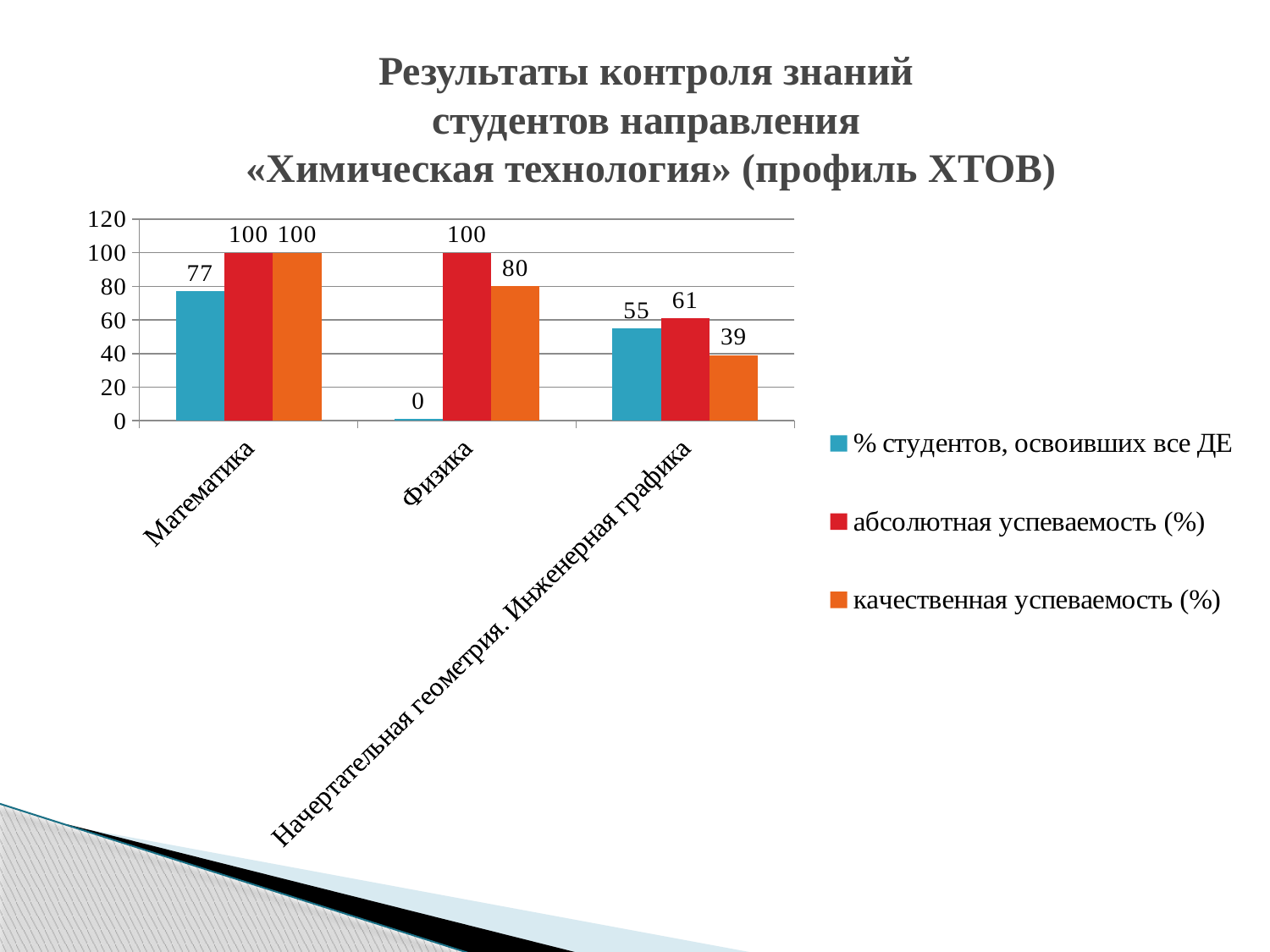
Which subject has the lowest value for «качественная успеваемость (%)»? Начертательная геометрия. Инженерная графика What is the value of «% студентов, освоивших все ДЕ» for Математика? 77 How many series does the legend list? 3 What is the difference between «абсолютная успеваемость (%)» and «качественная успеваемость (%)» for Начертательная геометрия. Инженерная графика? 22 Which subject has the highest value for «% студентов, освоивших все ДЕ»? Математика How many subject categories are shown on the x axis? 3 Does the value of «% студентов, освоивших все ДЕ» rise or fall from Математика to Начертательная геометрия. Инженерная графика? fall What kind of chart is shown on the slide? bar chart Which is larger: «качественная успеваемость (%)» for Физика or for Начертательная геометрия. Инженерная графика? Физика What is the value of «% студентов, освоивших все ДЕ» for Физика? 0 What is the value of «абсолютная успеваемость (%)» for Начертательная геометрия. Инженерная графика? 61 What is the value of «качественная успеваемость (%)» for Физика? 80